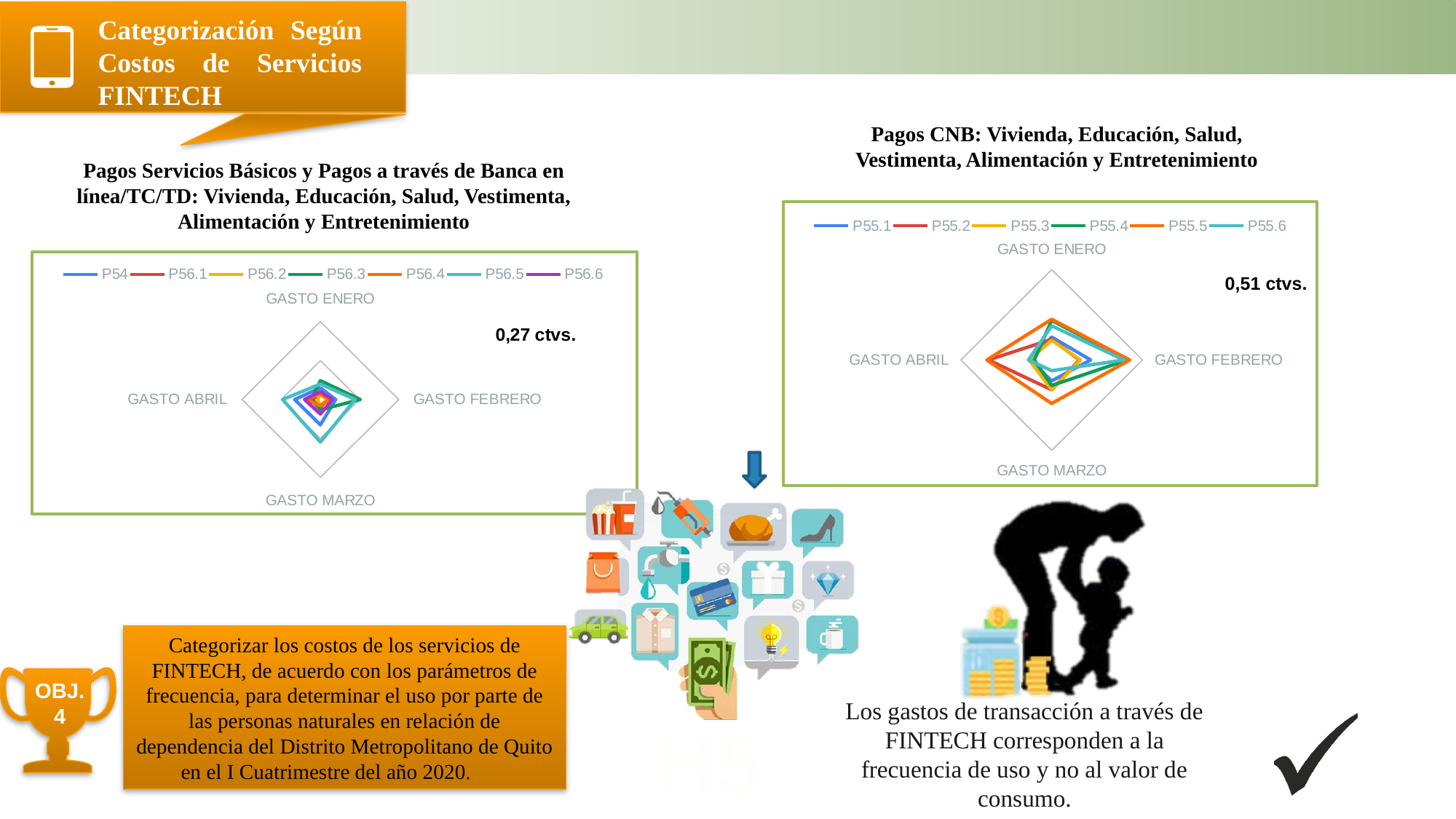
What type of chart is the left chart titled 'Pagos Servicios Básicos y Pagos a través de Banca en línea/TC/TD'? Radar chart How many axis categories (months) does the right chart (Pagos CNB) have? 4 How many axis categories (months) does the left chart (Pagos Servicios Básicos) have? 4 In the right chart (Pagos CNB), which series has the larger extent along the GASTO ABRIL axis, P55.5 or P55.3? P55.5 What value is annotated in the top-right corner of the right chart (Pagos CNB)? 0,51 ctvs. In the left chart (Pagos Servicios Básicos), which series extends furthest along the GASTO MARZO axis? P56.5 What type of chart is the right chart titled 'Pagos CNB'? Radar chart In the right chart (Pagos CNB), which series extends furthest along the GASTO MARZO axis? P55.5 What value is annotated in the top-right corner of the left chart (Pagos Servicios Básicos)? 0,27 ctvs. How many series does the legend of the left chart (Pagos Servicios Básicos) list? 7 How many series does the legend of the right chart (Pagos CNB) list? 6 In the right chart (Pagos CNB), which series extends furthest along the GASTO FEBRERO axis? P55.5